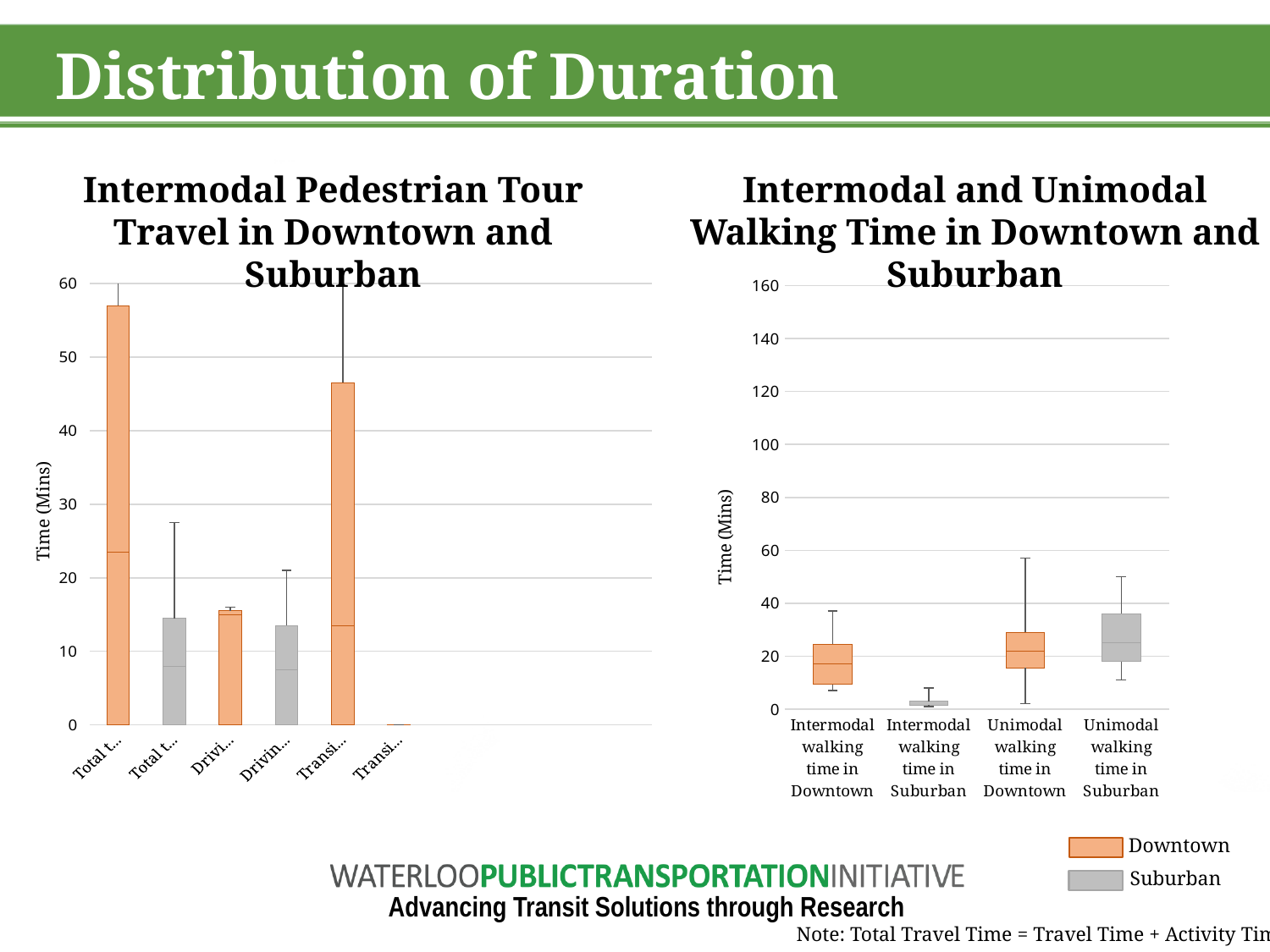
How many categories are shown on the x axis of the chart titled 'Intermodal Pedestrian Tour Travel in Downtown and Suburban'? 6 In the chart titled 'Intermodal and Unimodal Walking Time in Downtown and Suburban', is the median for Intermodal walking time in Suburban greater or less than 20? less How many series does the legend at the bottom right of the slide list? 2 In the chart titled 'Intermodal and Unimodal Walking Time in Downtown and Suburban', which category has the highest upper whisker? Unimodal walking time in Downtown In the chart titled 'Intermodal Pedestrian Tour Travel in Downtown and Suburban', is the top of the first (leftmost) box greater or less than 50? greater In the chart titled 'Intermodal and Unimodal Walking Time in Downtown and Suburban', is the upper whisker for Unimodal walking time in Downtown greater or less than 40? greater In the legend, which series is shown in orange? Downtown What kind of chart is the chart titled 'Intermodal and Unimodal Walking Time in Downtown and Suburban'? Box-and-whisker chart What is the y-axis label of the chart titled 'Intermodal and Unimodal Walking Time in Downtown and Suburban'? Time (Mins) How many categories are shown on the x axis of the chart titled 'Intermodal and Unimodal Walking Time in Downtown and Suburban'? 4 In the chart titled 'Intermodal and Unimodal Walking Time in Downtown and Suburban', which has the larger median: Unimodal walking time in Suburban or Intermodal walking time in Suburban? Unimodal walking time in Suburban In the chart titled 'Intermodal and Unimodal Walking Time in Downtown and Suburban', which category has the lowest median? Intermodal walking time in Suburban